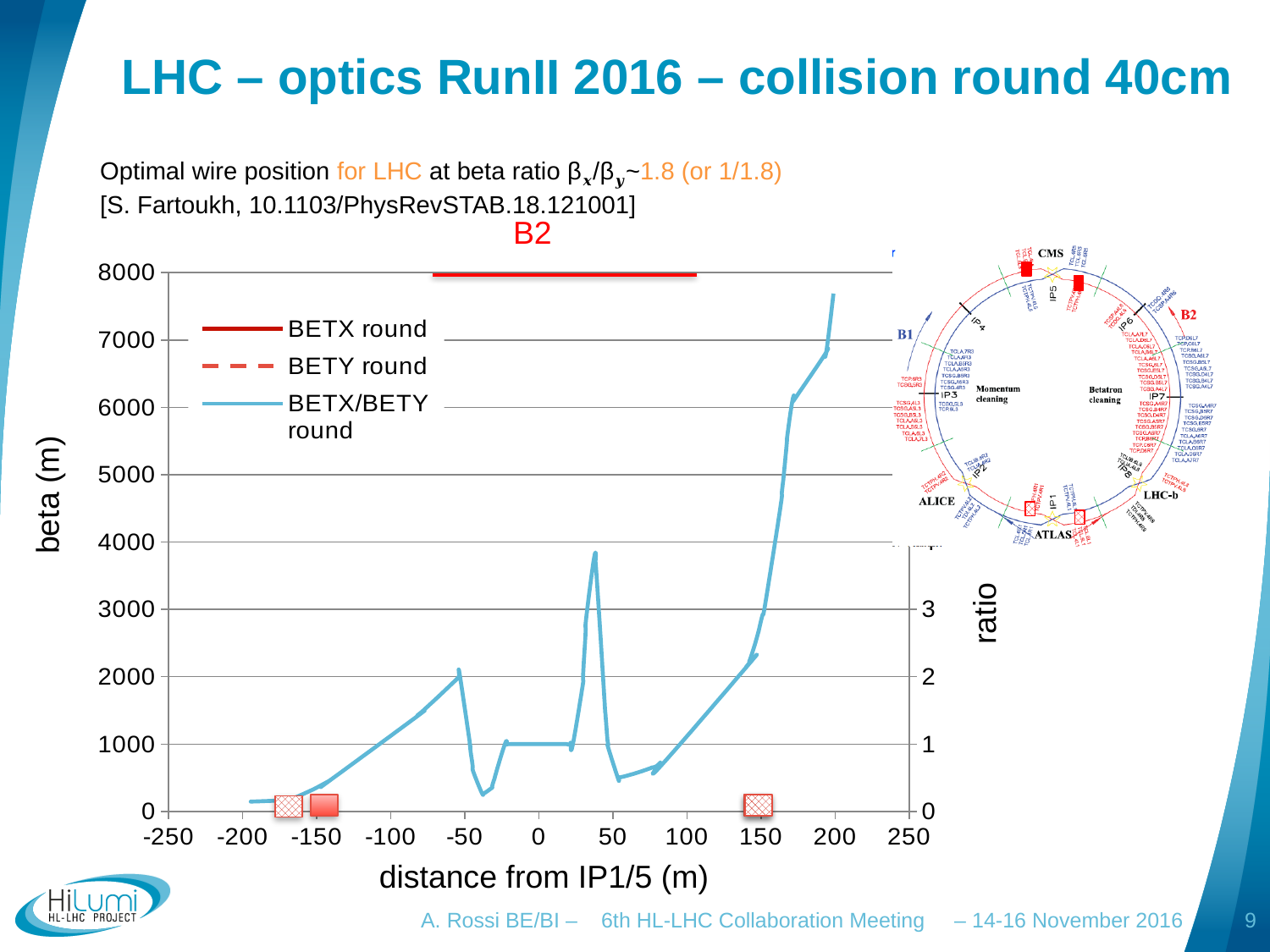
Does the BETX/BETY round line rise or fall as the distance increases from -200 m to -50 m? rise What is the title of the left y axis of the chart? beta (m) What is the minimum value shown on the x axis of the chart? -250 What kind of chart is shown on the slide? line chart How many series does the chart legend list? 3 Does the BETX/BETY round line rise or fall as the distance increases from 100 m to 200 m? rise On the right-hand ratio axis, is the BETX/BETY round value at a distance of 200 m greater or less than 2? greater What is the maximum value shown on the left y axis of the chart? 8000 What is the title of the x axis of the chart? distance from IP1/5 (m) On the right-hand ratio axis, is the BETX/BETY round value at a distance of 50 m greater or less than 1? less